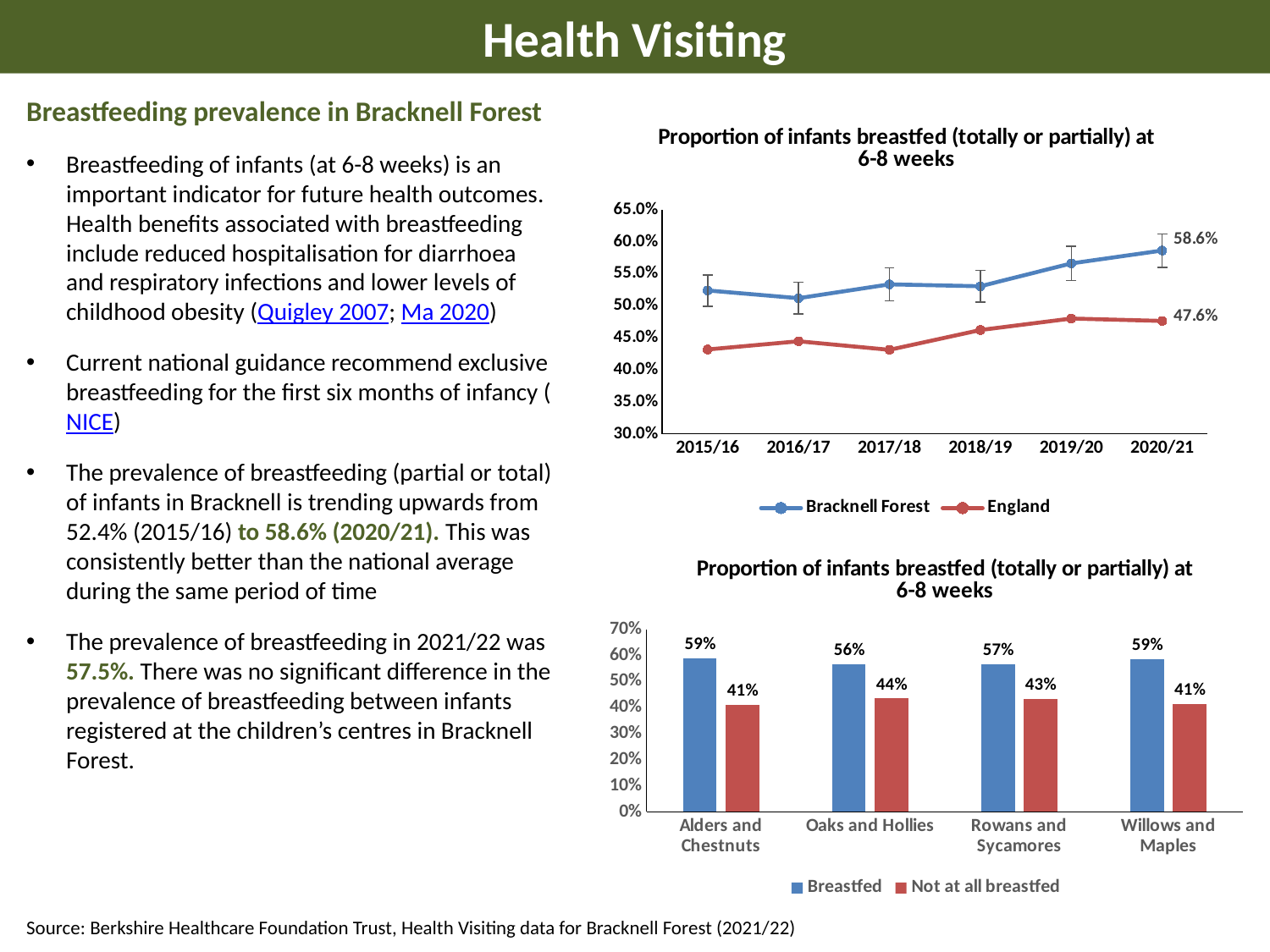
What kind of chart is the bottom chart on the slide? Bar chart In the top chart, what is the difference between the Bracknell Forest and England values in 2020/21? 11.0 percentage points In the top chart, does the Bracknell Forest line generally rise or fall from 2015/16 to 2020/21? Rise How many time periods are shown on the x axis of the top chart? 6 How many series does the legend of the top chart list? 2 In the top chart, what is the value for England in 2020/21? 47.6% In the top chart, what is the value for Bracknell Forest in 2020/21? 58.6% How many children's centres are shown in the bottom chart? 4 In the top chart, is the value for England in 2015/16 greater or less than 45.0%? less What kind of chart is the top chart on the slide? Line chart In the bottom chart, which children's centre has the highest Not at all breastfed value? Oaks and Hollies In the bottom chart, what is the Breastfed value for Oaks and Hollies? 56%